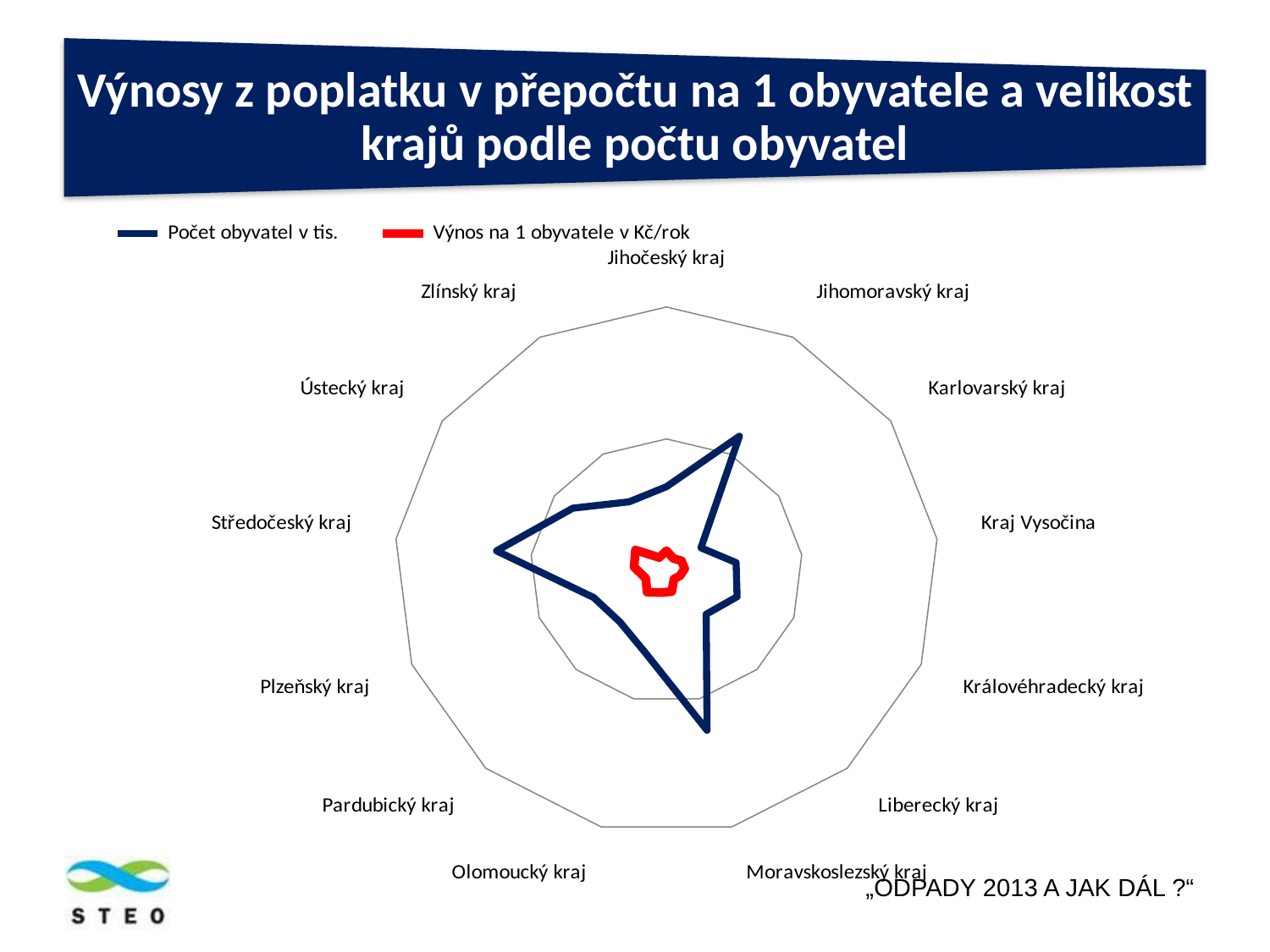
For the series 'Počet obyvatel v tis.', which region has the larger value: Středočeský kraj or Karlovarský kraj? Středočeský kraj For the series 'Počet obyvatel v tis.', which region has the larger value: Středočeský kraj or Plzeňský kraj? Středočeský kraj Which colour represents the series 'Výnos na 1 obyvatele v Kč/rok'? Red What are the two series named in the legend? Počet obyvatel v tis.; Výnos na 1 obyvatele v Kč/rok Which series extends further from the centre of the radar chart overall: 'Počet obyvatel v tis.' or 'Výnos na 1 obyvatele v Kč/rok'? Počet obyvatel v tis. Which region label appears at the top of the radar chart? Jihočeský kraj How many regions (categories) are plotted on the radar chart? 13 What kind of chart is shown on the slide? Radar chart How many series does the legend list? 2